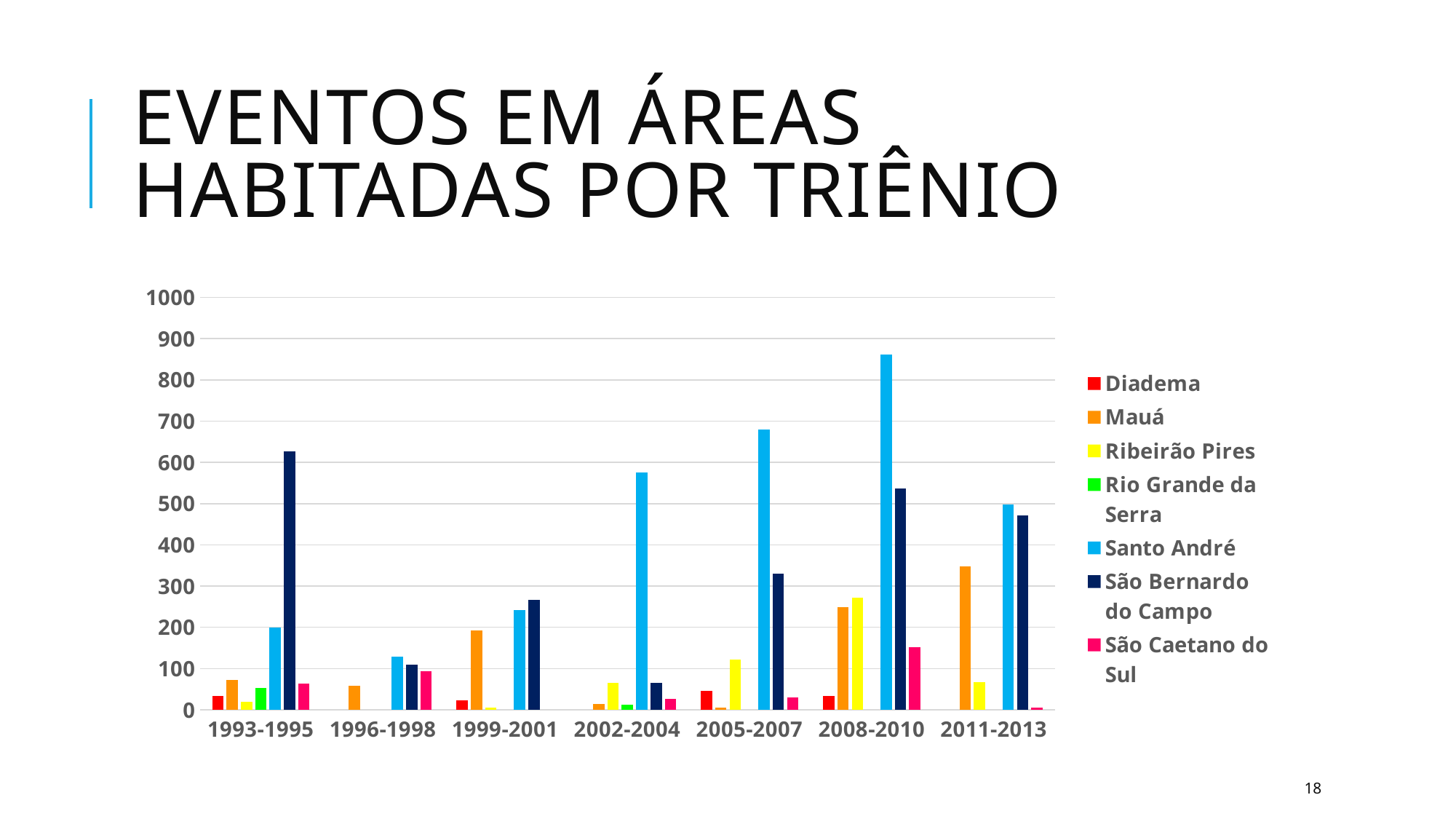
In 2011-2013, which is larger: Mauá or Ribeirão Pires? Mauá In the 1993-1995 triennium, which municipality has the highest bar? São Bernardo do Campo In which triennium is the Santo André bar the highest? 2008-2010 Is the value for São Bernardo do Campo in 1993-1995 greater or less than 600? greater In which triennium is the Santo André bar the lowest? 1996-1998 In 2005-2007, which is larger: Santo André or São Bernardo do Campo? Santo André Is the value for Mauá in 2011-2013 greater or less than 300? greater How many series does the legend list? 7 How many triennia are shown on the x axis? 7 Is the value for Santo André in 2008-2010 greater or less than 800? greater What kind of chart is shown on the slide? bar chart Does the Santo André series rise or fall from 1999-2001 to 2008-2010? rise